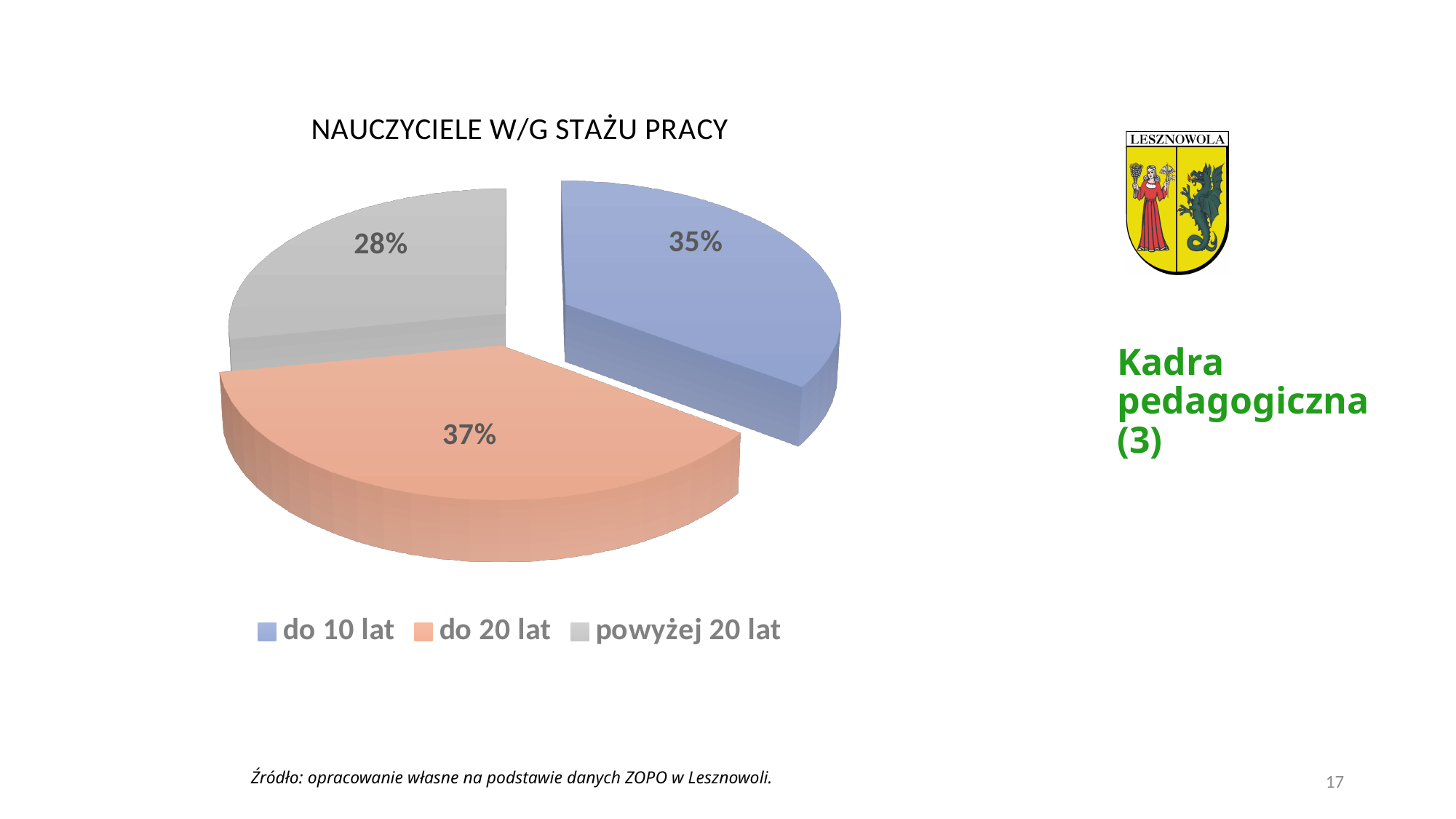
Which category has the smallest share of the pie? powyżej 20 lat How many slices does the pie chart have? 3 What is the difference in percentage points between 'do 10 lat' and 'powyżej 20 lat'? 7 What share of the pie is 'powyżej 20 lat'? 28% Which category has the largest share of the pie? do 20 lat What share of the pie is 'do 20 lat'? 37% What is the chart's title? NAUCZYCIELE W/G STAŻU PRACY What kind of chart is shown on the slide? pie chart Which is larger, the share for 'do 10 lat' or for 'powyżej 20 lat'? do 10 lat What is the difference in percentage points between 'do 20 lat' and 'powyżej 20 lat'? 9 Which colour represents 'do 20 lat' in the legend? orange What share of the pie is 'do 10 lat'? 35%